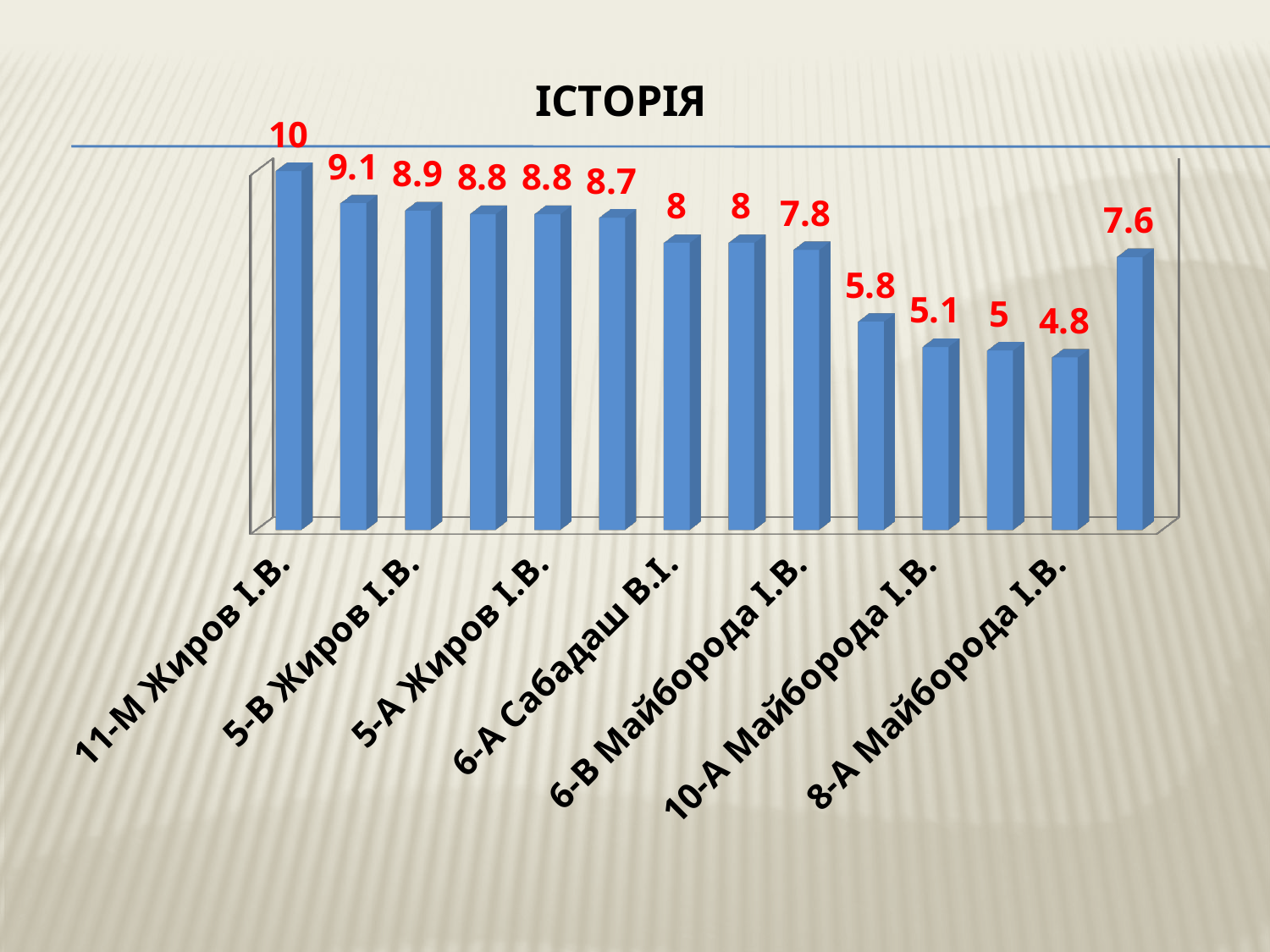
What is the value for 6-А Сабадаш В.І.? 8 What is the value for 5-В Жиров І.В.? 8.9 What is the title of the chart? ІСТОРІЯ What is the value for 11-М Жиров І.В.? 10 What is the value for 6-В Майборода І.В.? 7.8 What is the value for 8-А Майборода І.В.? 4.8 Which is larger, the value for 5-А Жиров І.В. or the value for 10-А Майборода І.В.? 5-А Жиров І.В. Which category has the highest value? 11-М Жиров І.В. How many bars are plotted in the chart? 14 Which category has the lowest value? 8-А Майборода І.В. What is the difference between the values for 11-М Жиров І.В. and 8-А Майборода І.В.? 5.2 What kind of chart is shown on the slide? Bar chart